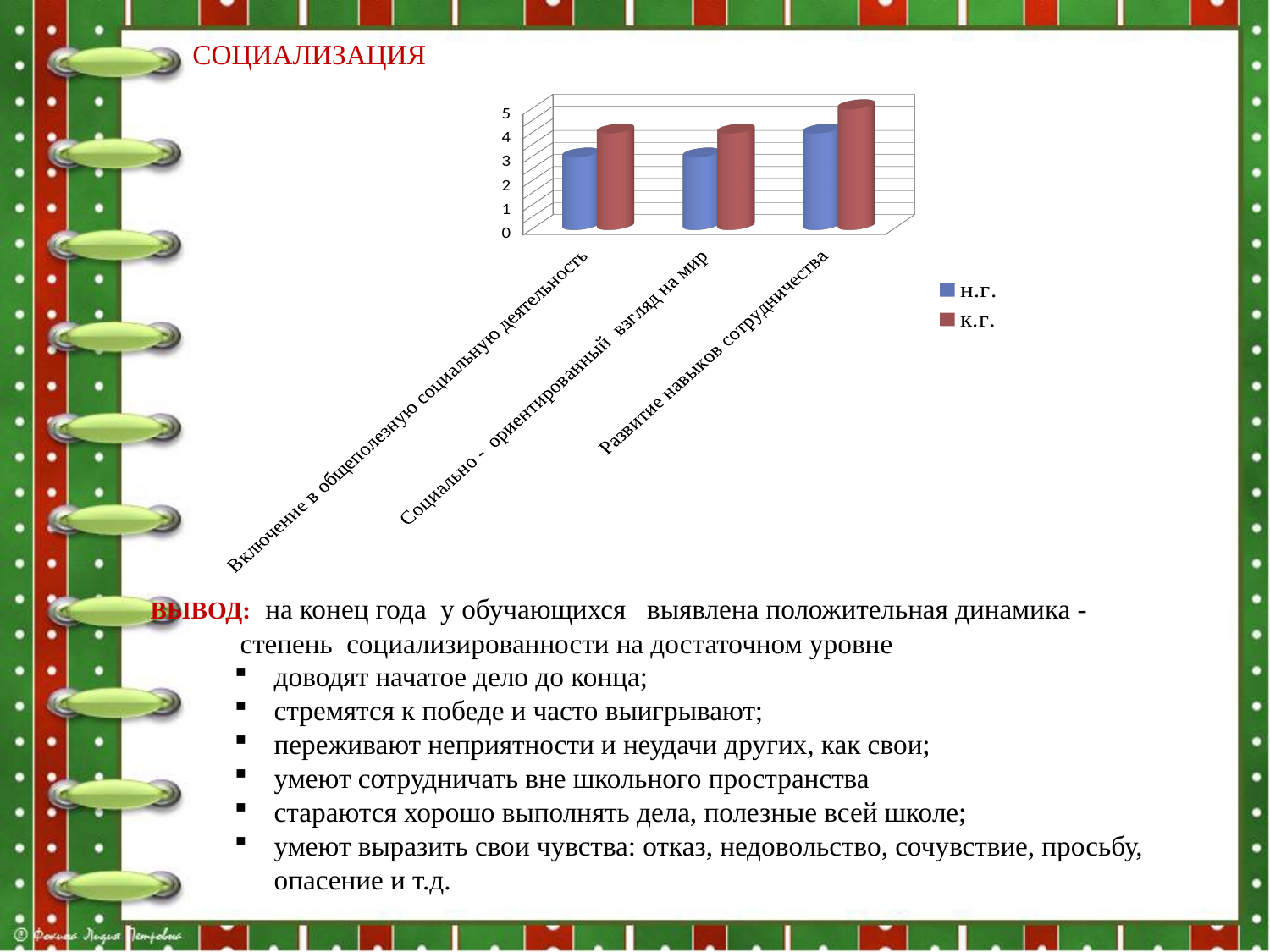
How many series does the chart legend list? 2 Which category has the highest value for the series н.г.? Развитие навыков сотрудничества Is the к.г. value for 'Развитие навыков сотрудничества' greater or less than 4? greater Is the к.г. value for 'Социально - ориентированный взгляд на мир' greater or less than 3? greater Which category has the highest value for the series к.г.? Развитие навыков сотрудничества What are the two series named in the chart legend? н.г. and к.г. How many categories are shown on the chart's x axis? 3 Which colour represents the series к.г. in the chart? red What kind of chart is shown on the slide? bar chart For the category 'Включение в общеполезную социальную деятельность', which series has the larger value, н.г. or к.г.? к.г. Is the н.г. value for 'Включение в общеполезную социальную деятельность' greater or less than 4? less For the category 'Развитие навыков сотрудничества', which series has the larger value, н.г. or к.г.? к.г.